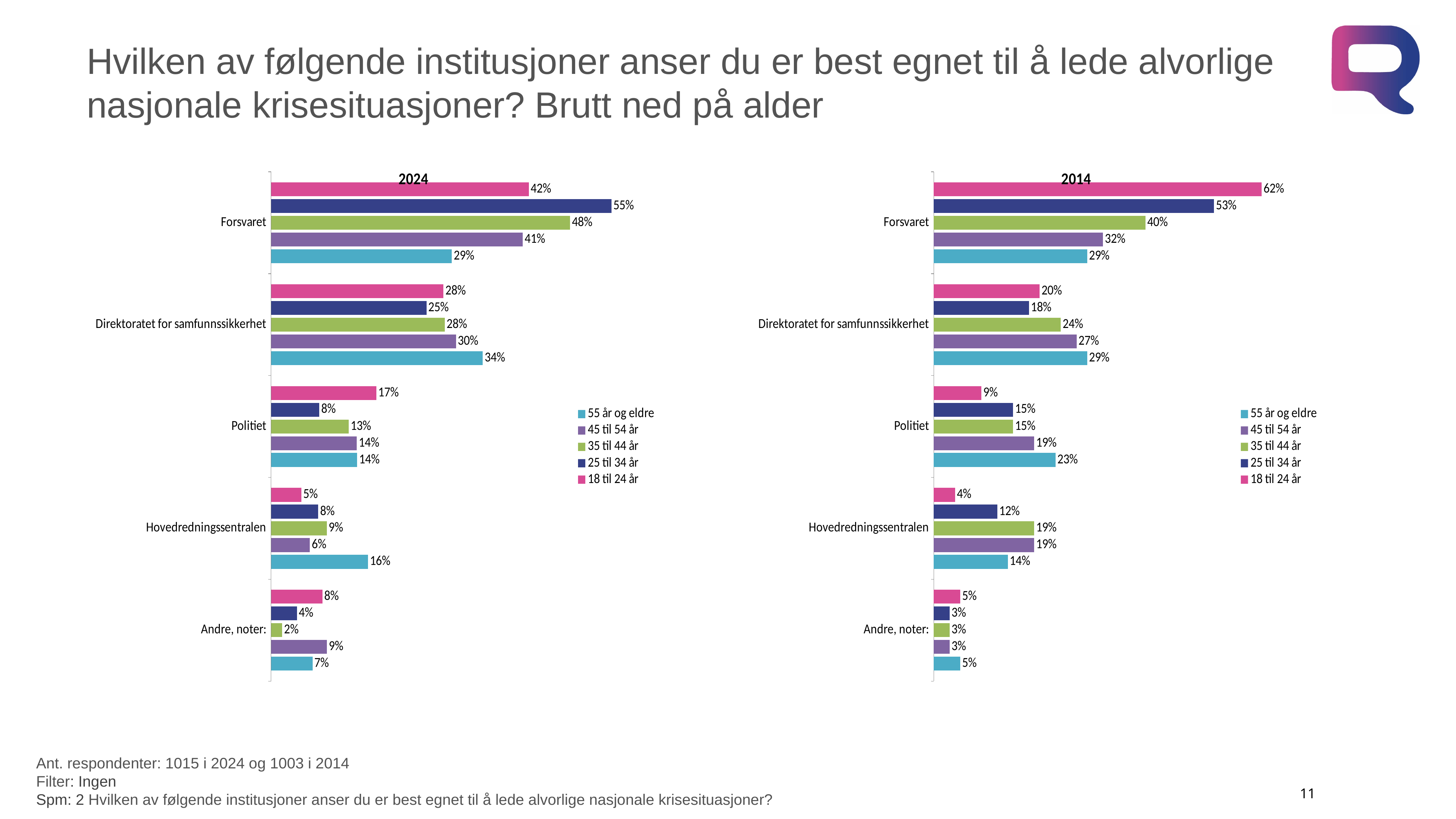
In the 2024 chart, which age group has the lowest value for Andre, noter:? 35 til 44 år In the 2014 chart, which colour represents the 18 til 24 år series? Pink What type of chart is the 2014 chart? Bar chart How many institution categories are shown in the 2024 chart? 5 How many series does the legend of the 2014 chart list? 5 In the 2014 chart, what is the value for Forsvaret among respondents aged 18 til 24 år? 62% In the 2014 chart, what is the value for Politiet among respondents aged 55 år og eldre? 23% In the 2014 chart, what is the difference between the 18 til 24 år value and the 55 år og eldre value for Forsvaret? 33 percentage points In the 2024 chart, what is the value for Forsvaret among respondents aged 25 til 34 år? 55% In the 2024 chart, what is the value for Hovedredningssentralen among respondents aged 55 år og eldre? 16% In the 2024 chart, which is larger for Direktoratet for samfunnssikkerhet: the value for 55 år og eldre or the value for 25 til 34 år? 55 år og eldre In the 2024 chart, which age group has the highest value for Forsvaret? 25 til 34 år